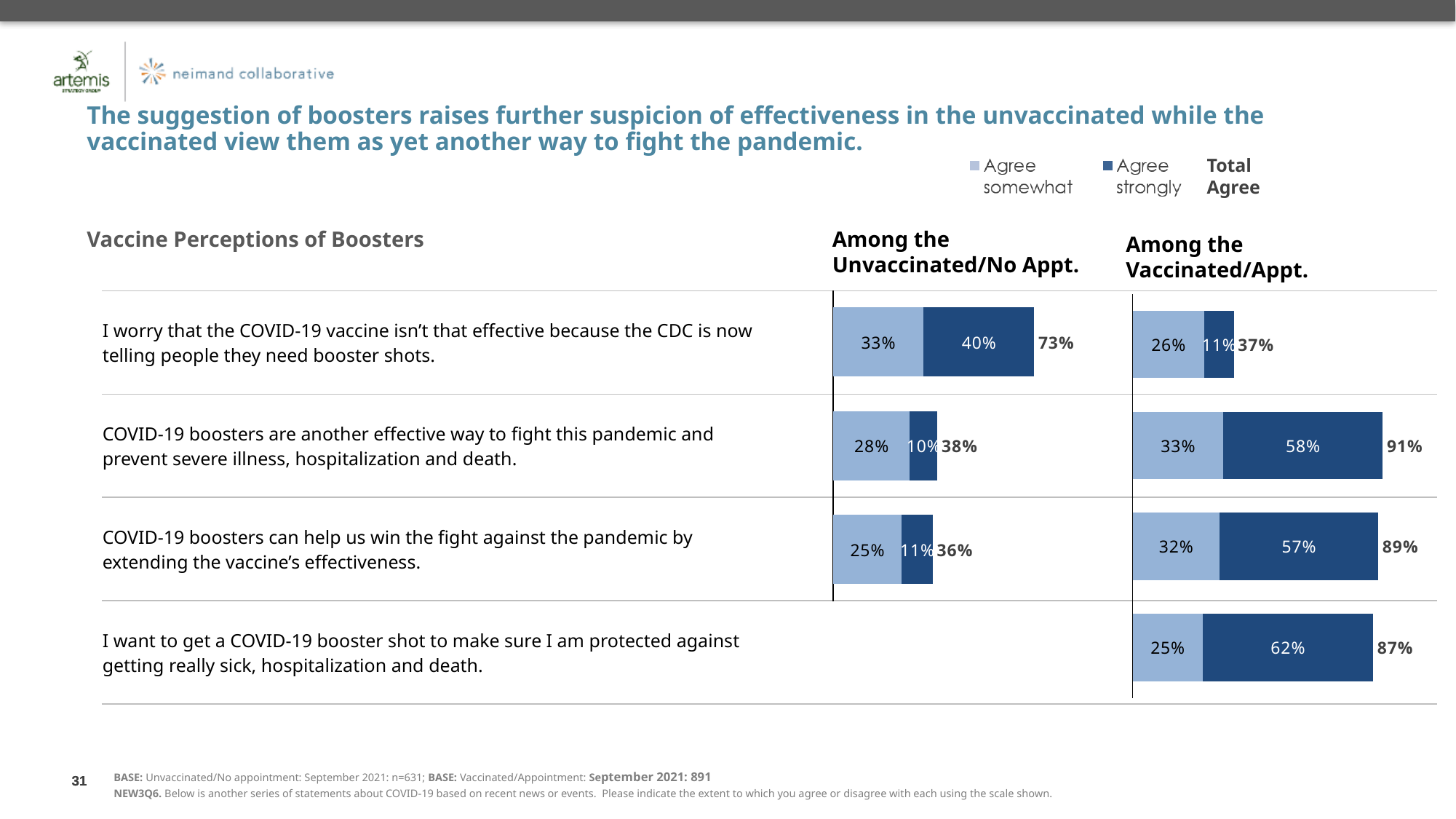
In the 'Among the Vaccinated/Appt.' chart, what is the Total Agree for 'COVID-19 boosters are another effective way to fight this pandemic and prevent severe illness, hospitalization and death'? 91% In the 'Among the Vaccinated/Appt.' chart, what is the 'Agree somewhat' value for the statement 'I want to get a COVID-19 booster shot to make sure I am protected against getting really sick, hospitalization and death'? 25% How many statements have bars plotted in the 'Among the Unvaccinated/No Appt.' chart? 3 In the 'Among the Unvaccinated/No Appt.' chart, what is the Total Agree for 'COVID-19 boosters can help us win the fight against the pandemic by extending the vaccine's effectiveness'? 36% How many statements have bars plotted in the 'Among the Vaccinated/Appt.' chart? 4 In the 'Among the Unvaccinated/No Appt.' chart, which statement has the highest Total Agree? I worry that the COVID-19 vaccine isn't that effective because the CDC is now telling people they need booster shots. What kind of chart is used in the 'Among the Vaccinated/Appt.' section? Stacked bar chart In the 'Among the Vaccinated/Appt.' chart, which is larger: the 'Agree strongly' value for 'I want to get a COVID-19 booster shot...' or for 'COVID-19 boosters can help us win the fight...'? I want to get a COVID-19 booster shot... What is the difference in Total Agree for 'COVID-19 boosters are another effective way to fight this pandemic...' between the 'Among the Vaccinated/Appt.' chart and the 'Among the Unvaccinated/No Appt.' chart? 53 percentage points How many series does the legend list for the charts? 2 In the 'Among the Vaccinated/Appt.' chart, which statement has the lowest Total Agree? I worry that the COVID-19 vaccine isn't that effective because the CDC is now telling people they need booster shots. In the 'Among the Unvaccinated/No Appt.' chart, what is the 'Agree strongly' value for the statement 'I worry that the COVID-19 vaccine isn't that effective because the CDC is now telling people they need booster shots'? 40%